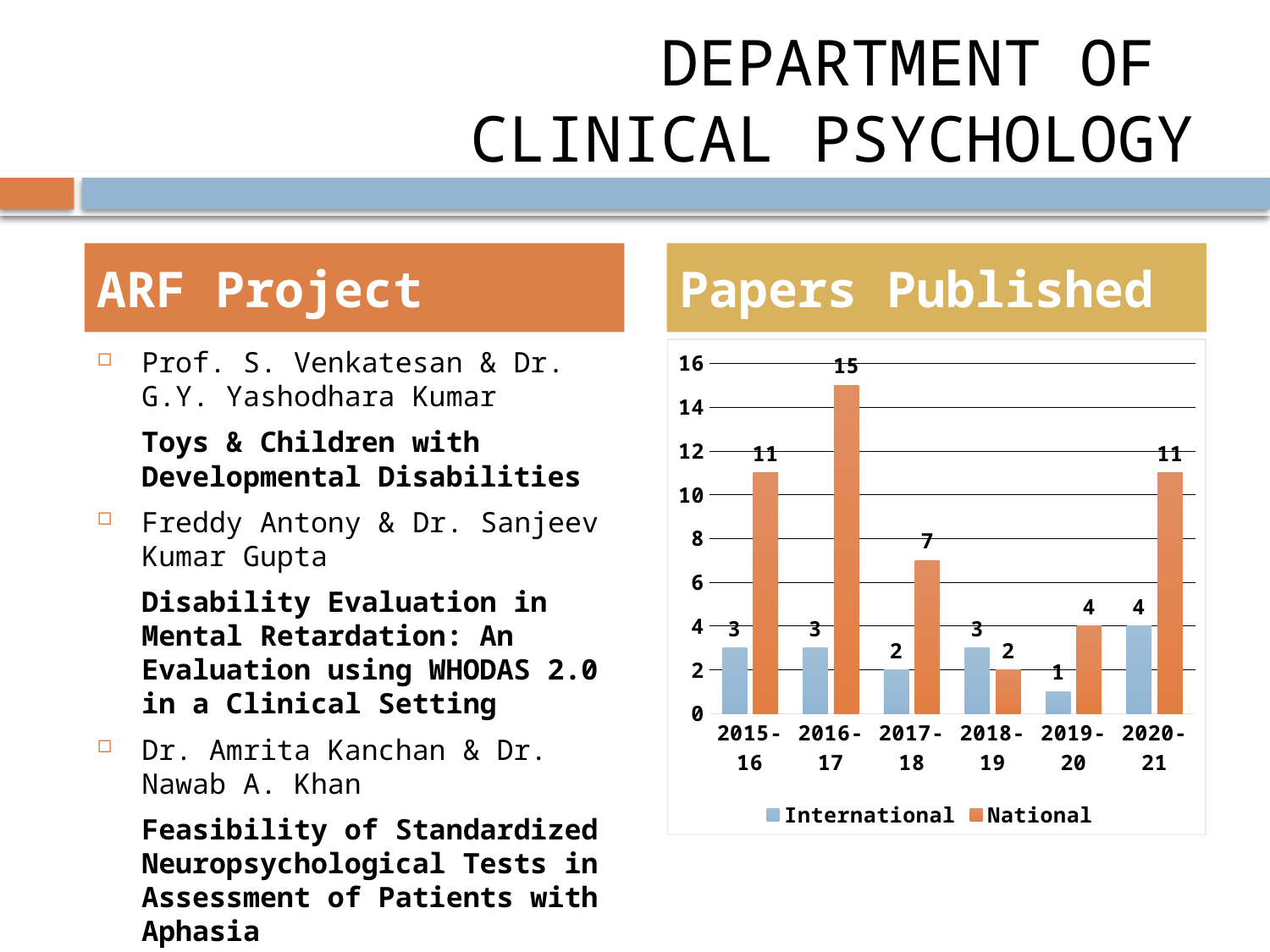
What colour represents the National series in the chart? Orange Which year has the lowest number of International papers? 2019-20 How many series does the legend list? 2 Which is larger in 2020-21, International or National papers? National What is the total number of papers (International plus National) published in 2017-18? 9 Which year has the highest number of National papers? 2016-17 What kind of chart is shown under Papers Published? Bar chart How many National papers were published in 2018-19? 2 What is the difference between National and International papers in 2015-16? 8 How many year categories are shown on the x axis? 6 How many International papers were published in 2019-20? 1 How many National papers were published in 2016-17? 15